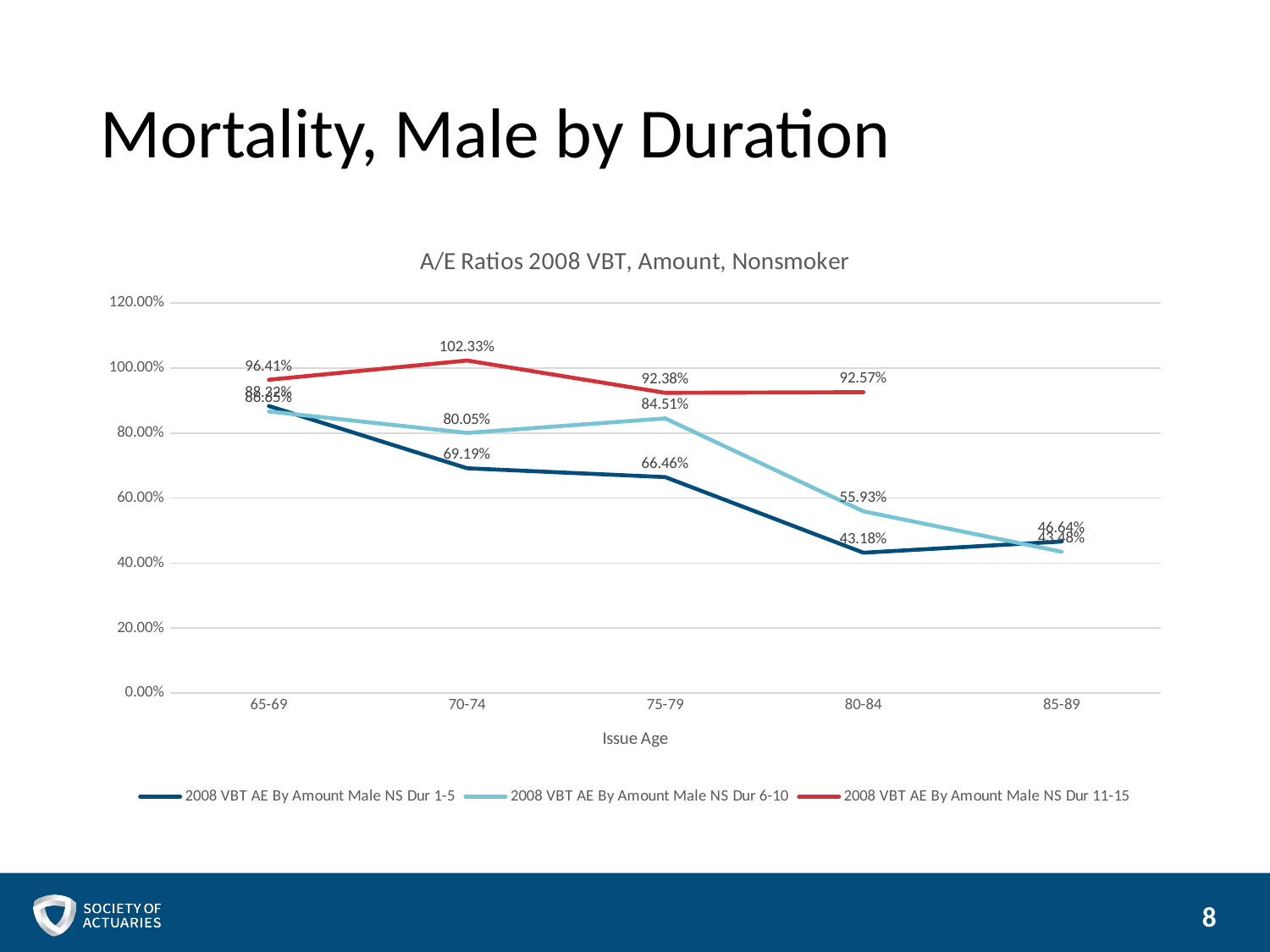
At which issue age does the 2008 VBT AE By Amount Male NS Dur 11-15 series reach its highest value? 70-74 How many series does the legend list? 3 How many issue age groups are shown on the x axis? 5 What is the difference between the Dur 11-15 value and the Dur 1-5 value at issue age 70-74? 33.14% What is the A/E ratio for 2008 VBT AE By Amount Male NS Dur 1-5 at issue age 80-84? 43.18% At issue age 75-79, which series has the larger value: Dur 6-10 or Dur 1-5? Dur 6-10 What type of chart is shown on the slide? Line chart Is the value for Dur 11-15 at issue age 70-74 greater or less than 100.00%? greater What is the A/E ratio for 2008 VBT AE By Amount Male NS Dur 6-10 at issue age 75-79? 84.51% What is the title of the chart? A/E Ratios 2008 VBT, Amount, Nonsmoker What is the A/E ratio for 2008 VBT AE By Amount Male NS Dur 11-15 at issue age 70-74? 102.33% At which issue age does the 2008 VBT AE By Amount Male NS Dur 1-5 series reach its lowest value? 80-84